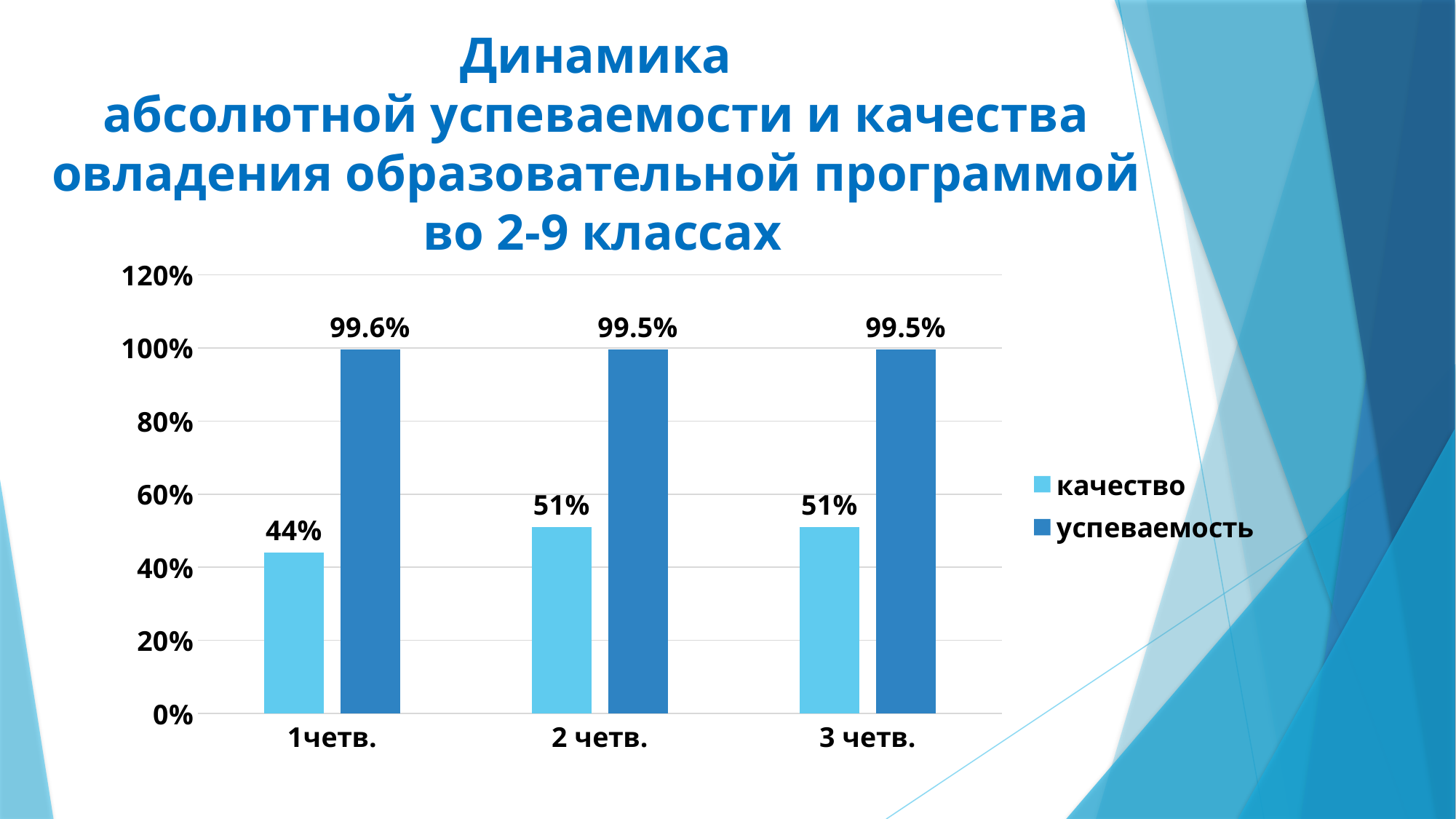
What is the difference between качество in 2 четв. and качество in 1четв.? 7% Does the качество value rise or fall from 1четв. to 2 четв.? rise How many series does the legend list? 2 Which quarter has the lowest качество value? 1четв. What kind of chart is shown on the slide? bar chart What is the value of успеваемость for 3 четв.? 99.5% Which is larger for 1четв.: качество or успеваемость? успеваемость Is the value of качество for 3 четв. greater or less than 40%? greater What is the value of качество for 1четв.? 44% How many quarters (categories) are shown on the x axis? 3 What is the value of успеваемость for 1четв.? 99.6% What is the value of качество for 2 четв.? 51%